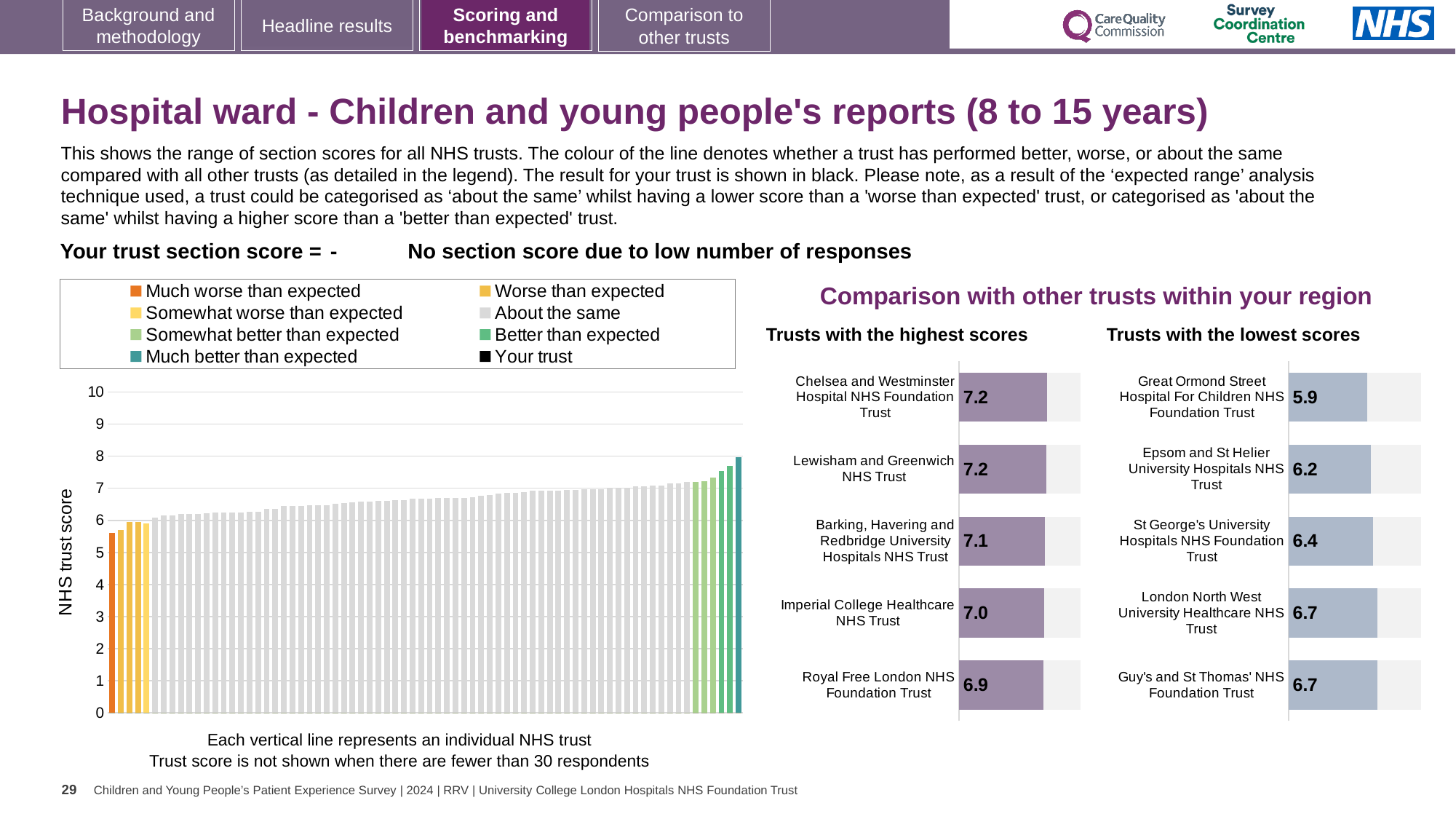
In the main 'NHS trust score' chart, do the bar values rise or fall from left to right? Rise In the 'Trusts with the highest scores' chart, which has the higher score: Barking, Havering and Redbridge University Hospitals NHS Trust or Imperial College Healthcare NHS Trust? Barking, Havering and Redbridge University Hospitals NHS Trust How many entries does the legend of the main 'NHS trust score' chart list? 8 In the 'Trusts with the lowest scores' chart, what is the difference between the scores of Guy's and St Thomas' NHS Foundation Trust and Great Ormond Street Hospital For Children NHS Foundation Trust? 0.8 What kind of chart is the main 'NHS trust score' chart on the left? Bar chart In the 'Trusts with the highest scores' chart, what is the difference between the scores of Chelsea and Westminster Hospital NHS Foundation Trust and Royal Free London NHS Foundation Trust? 0.3 In the 'Trusts with the highest scores' chart, which trust has the lowest score? Royal Free London NHS Foundation Trust How many trusts are shown in the 'Trusts with the highest scores' chart? 5 In the 'Trusts with the lowest scores' chart, what is the score for St George's University Hospitals NHS Foundation Trust? 6.4 In the 'Trusts with the highest scores' chart, what is the score for Imperial College Healthcare NHS Trust? 7.0 In the 'Trusts with the lowest scores' chart, which trust has the lowest score? Great Ormond Street Hospital For Children NHS Foundation Trust In the 'Trusts with the lowest scores' chart, what is the score for Great Ormond Street Hospital For Children NHS Foundation Trust? 5.9